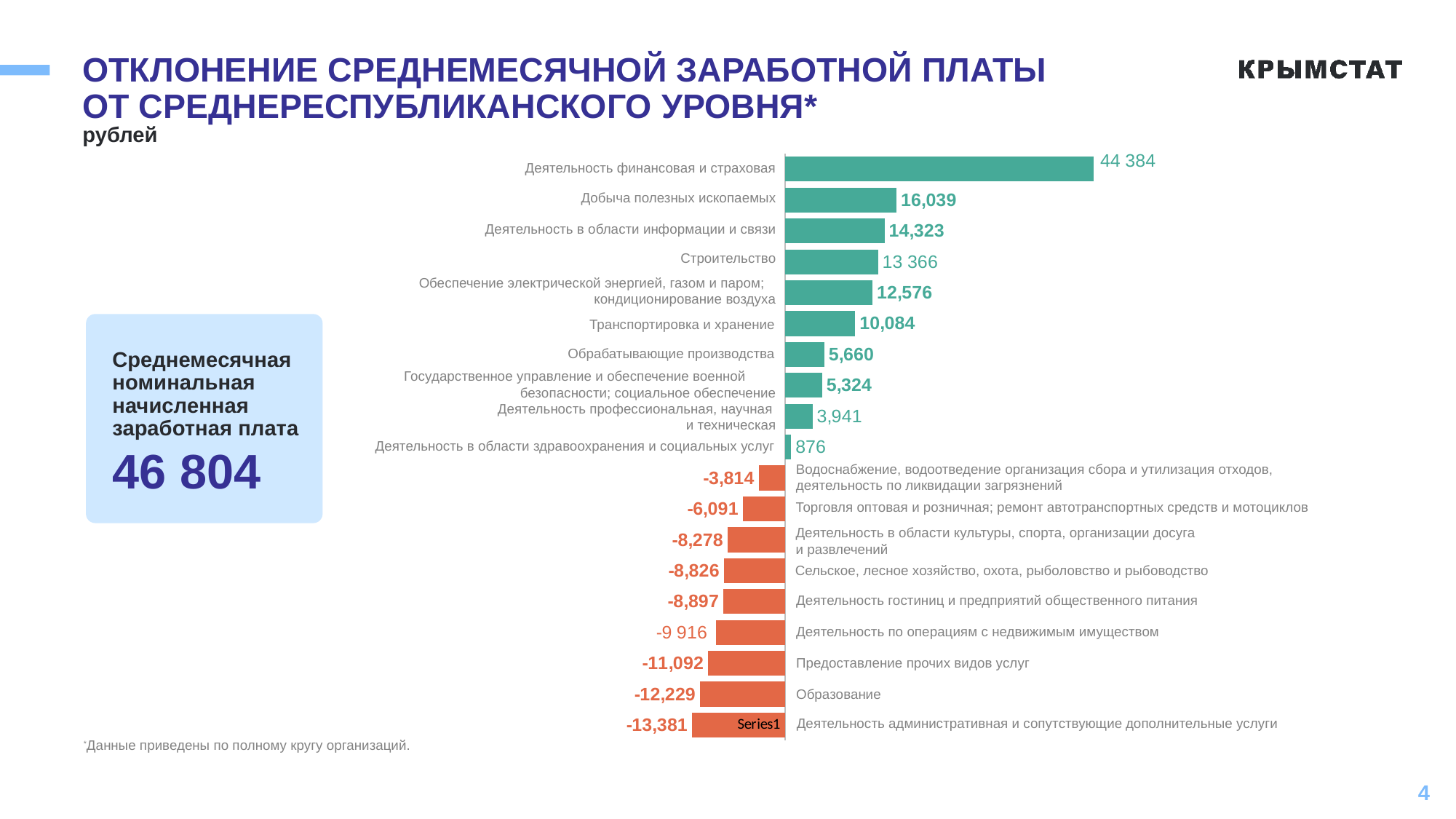
What is the value of the average monthly nominal accrued wage shown in the box on the left? 46 804 Which category has the lowest value? Деятельность административная и сопутствующие дополнительные услуги How many categories have negative values? 9 What is the difference between the values for Добыча полезных ископаемых and Деятельность в области информации и связи? 1,716 What kind of chart is shown on the slide? bar chart What is the value for Транспортировка и хранение? 10,084 What is the value for Деятельность финансовая и страховая? 44 384 What is the value for Строительство? 13 366 What is the value for Образование? -12,229 Which is larger, the value for Обрабатывающие производства or the value for Государственное управление и обеспечение военной безопасности; социальное обеспечение? Обрабатывающие производства How many categories are shown in the chart? 19 Which category has the highest value? Деятельность финансовая и страховая